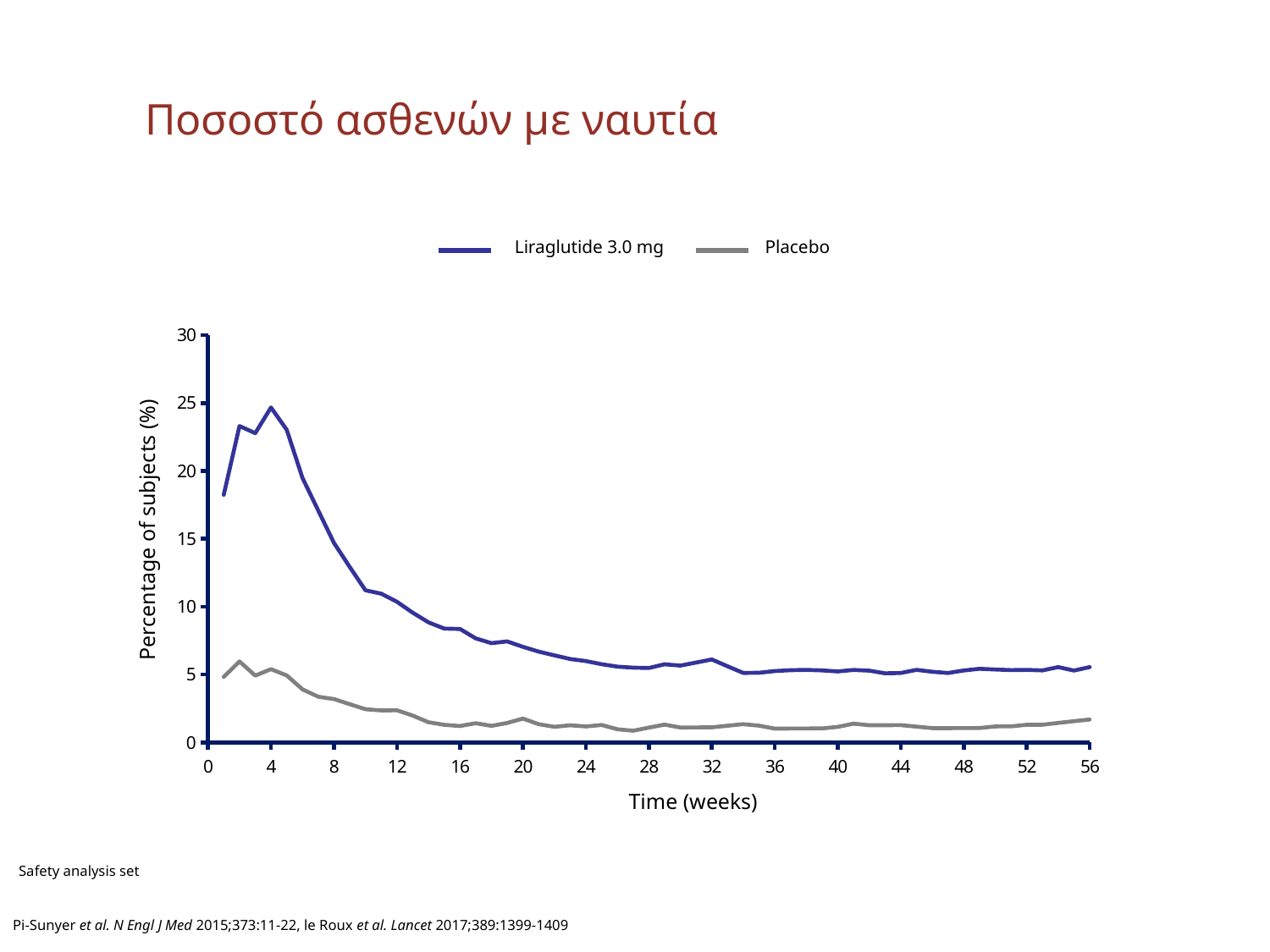
Is the value for Liraglutide 3.0 mg at week 56 greater or less than 10? less Which series reaches the highest percentage of subjects on the chart? Liraglutide 3.0 mg Does the Liraglutide 3.0 mg line rise or fall between week 4 and week 56? Fall Is the value for Liraglutide 3.0 mg at week 4 greater or less than 20? greater Around which week does the Liraglutide 3.0 mg line reach its peak? Week 4 At week 4, which series has the higher value, Liraglutide 3.0 mg or Placebo? Liraglutide 3.0 mg What is the label of the x axis? Time (weeks) What are the two series named in the legend? Liraglutide 3.0 mg and Placebo How many series does the legend list? 2 What kind of chart is shown on the slide? Line chart Is the value for Liraglutide 3.0 mg at week 12 greater or less than 5? greater